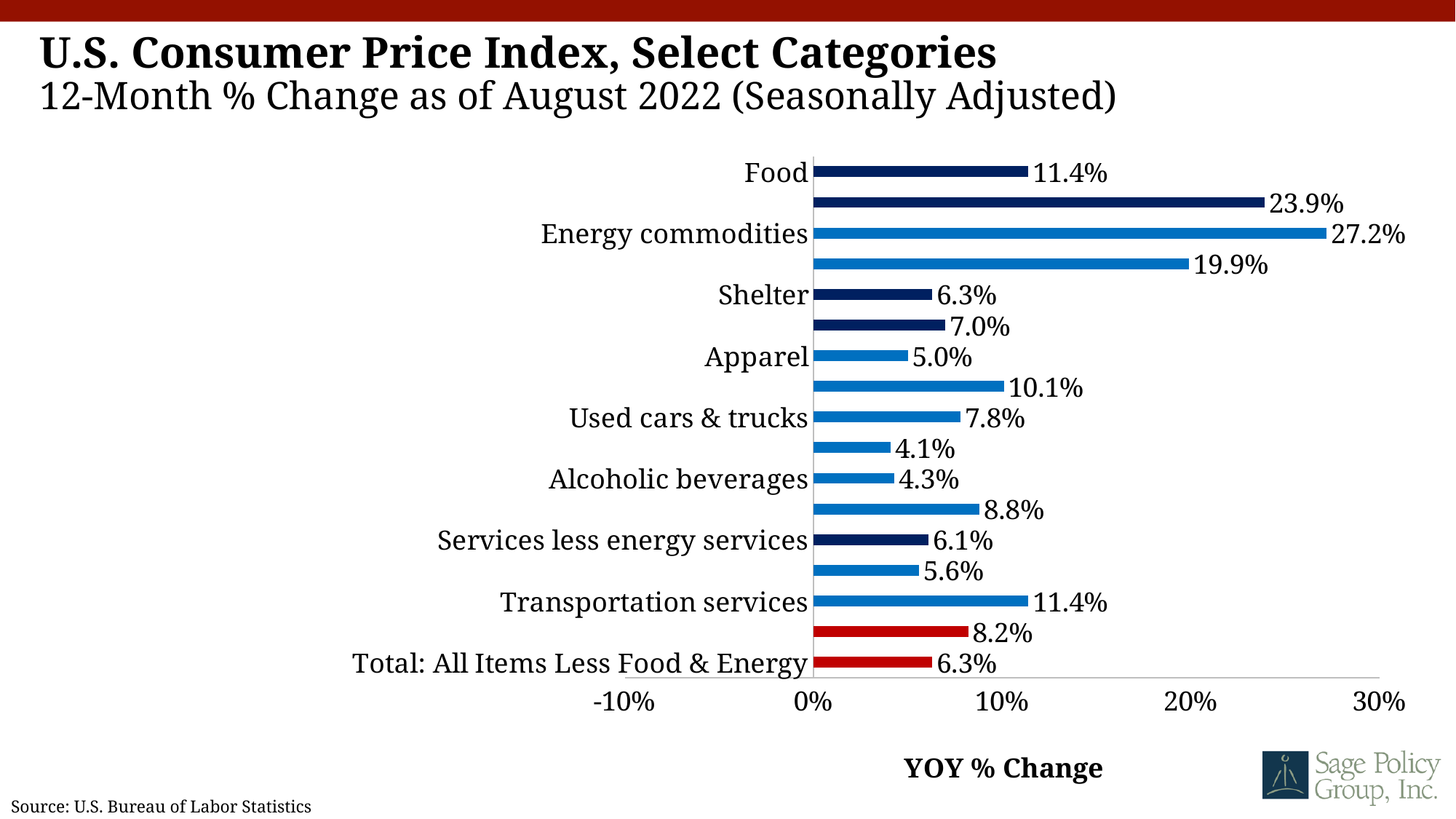
What is the value shown for Used cars & trucks? 7.8% What is the title of the horizontal axis? YOY % Change Which is larger, the value for Apparel or the value for Alcoholic beverages? Apparel What is the difference between the values for Energy commodities and Food? 15.8 percentage points What is the value shown for Total: All Items Less Food & Energy? 6.3% What is the value shown for Food? 11.4% What is the 12-month % change for Energy commodities? 27.2% Is the value for Services less energy services greater or less than 10%? less What kind of chart is shown on the slide? Bar chart Is the value for Energy commodities greater or less than 20%? greater Which labeled category has the highest 12-month % change? Energy commodities How many bars are plotted in the chart? 17